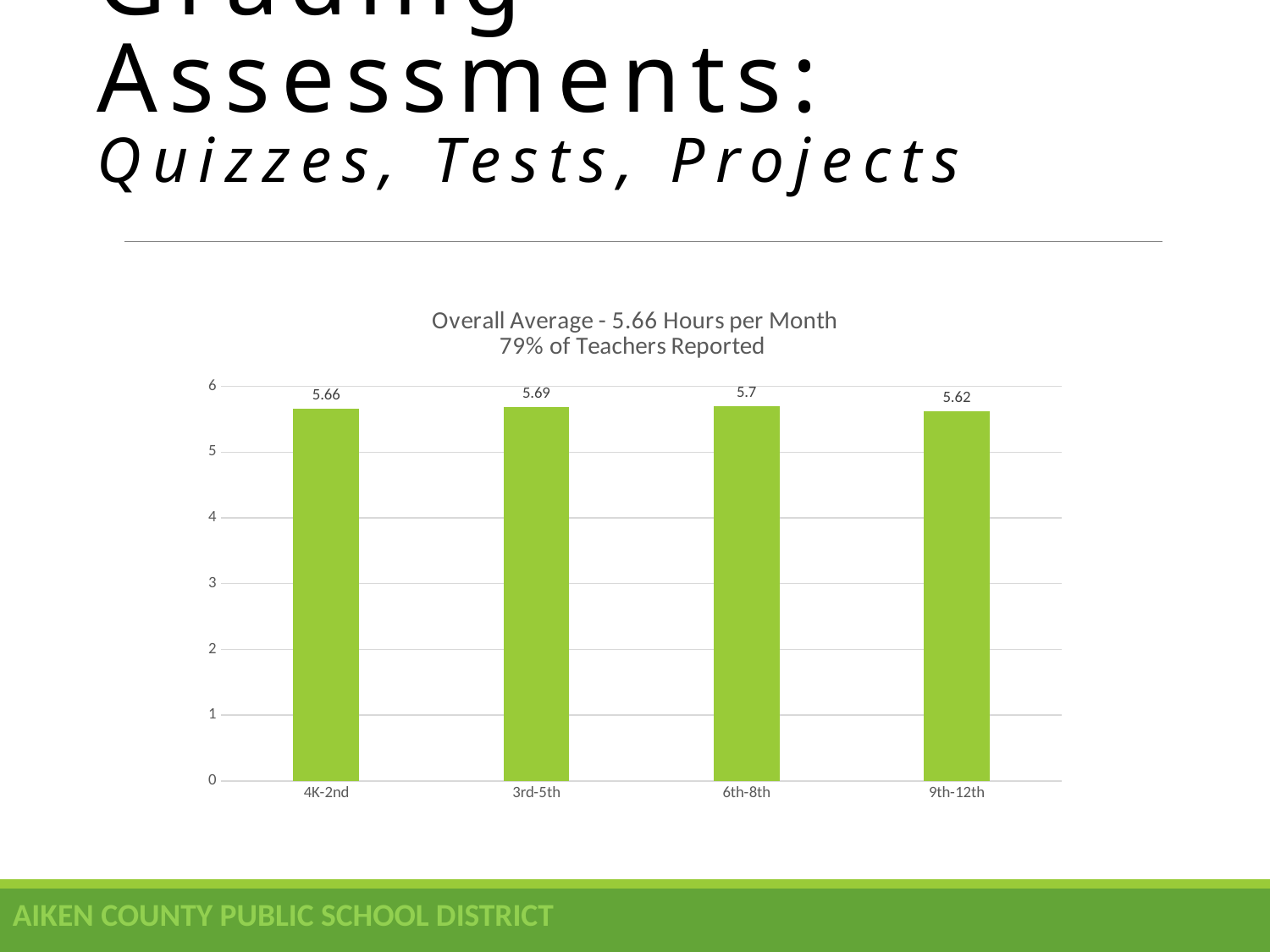
What is the value for 3rd-5th? 5.69 Is the value for 9th-12th greater or less than 5? greater How many grade bands are shown on the chart? 4 What is the value for 9th-12th? 5.62 What overall average is stated in the chart title? 5.66 Hours per Month What is the value for 6th-8th? 5.7 Which is larger, the value for 3rd-5th or the value for 9th-12th? 3rd-5th Which grade band has the highest value? 6th-8th What kind of chart is shown on the slide? bar chart What is the value for 4K-2nd? 5.66 Which grade band has the lowest value? 9th-12th What is the difference between the values for 6th-8th and 9th-12th? 0.08